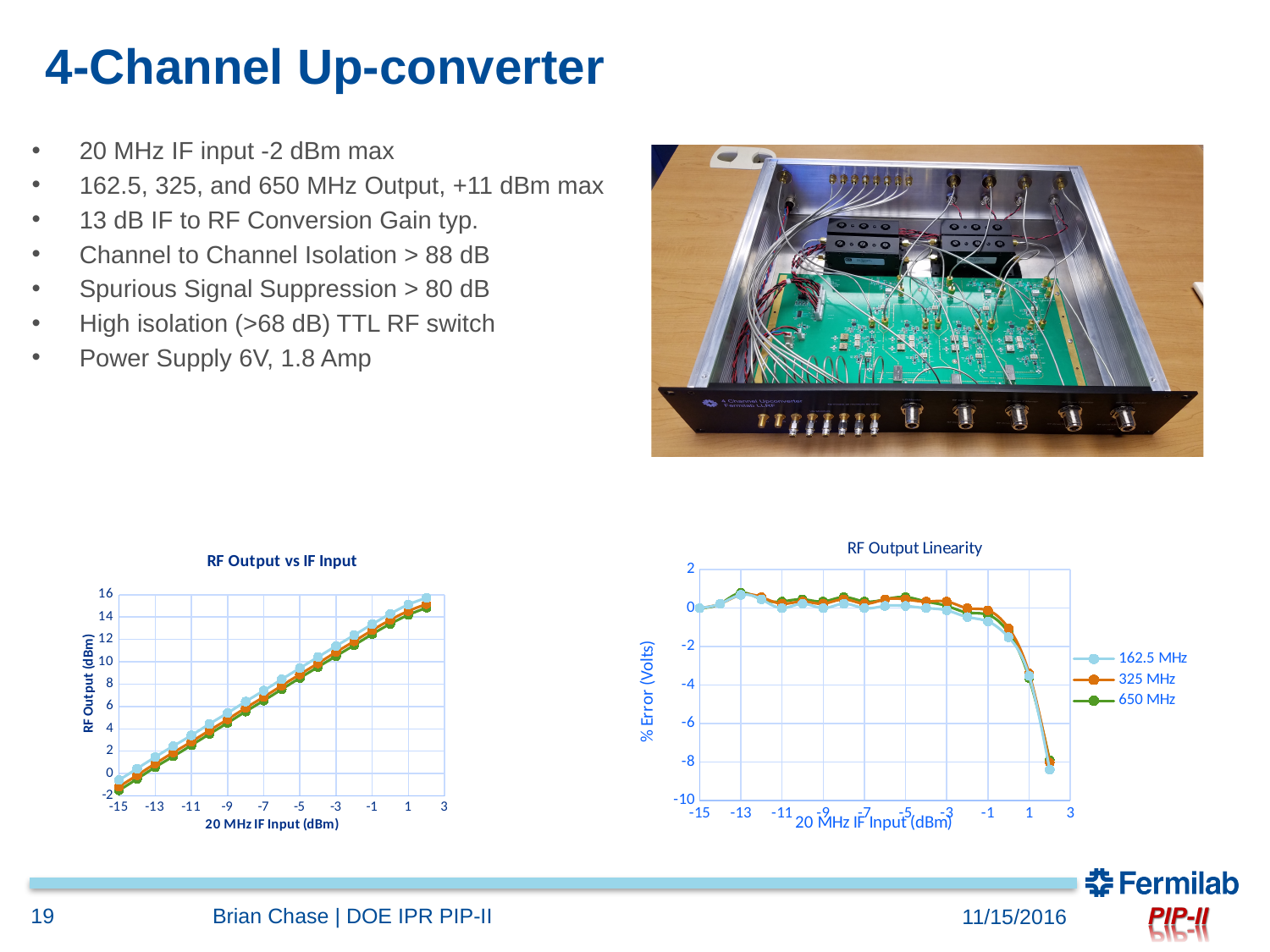
In the 'RF Output vs IF Input' chart, is the RF output at an IF input of 2 dBm greater or less than 12 dBm? greater What is the y-axis title of the 'RF Output Linearity' chart? % Error (Volts) What is the x-axis title of the 'RF Output vs IF Input' chart? 20 MHz IF Input (dBm) In the 'RF Output vs IF Input' chart, do the values rise or fall as the IF input increases from -15 to 3 dBm? Rise In the 'RF Output Linearity' chart, is the % Error for 162.5 MHz at an IF input of 2 dBm greater or less than -6? less How many series does the legend of the 'RF Output Linearity' chart list? 3 What kind of chart is the 'RF Output vs IF Input' chart? Line chart In the 'RF Output Linearity' chart, which series has the lowest % Error at an IF input of 2 dBm? 162.5 MHz In the 'RF Output Linearity' chart, do the % Error values rise or fall as the IF input goes from -1 to 3 dBm? Fall What kind of chart is the 'RF Output Linearity' chart? Line chart In the 'RF Output Linearity' chart, is the % Error for 325 MHz at an IF input of -13 dBm greater or less than -2? greater